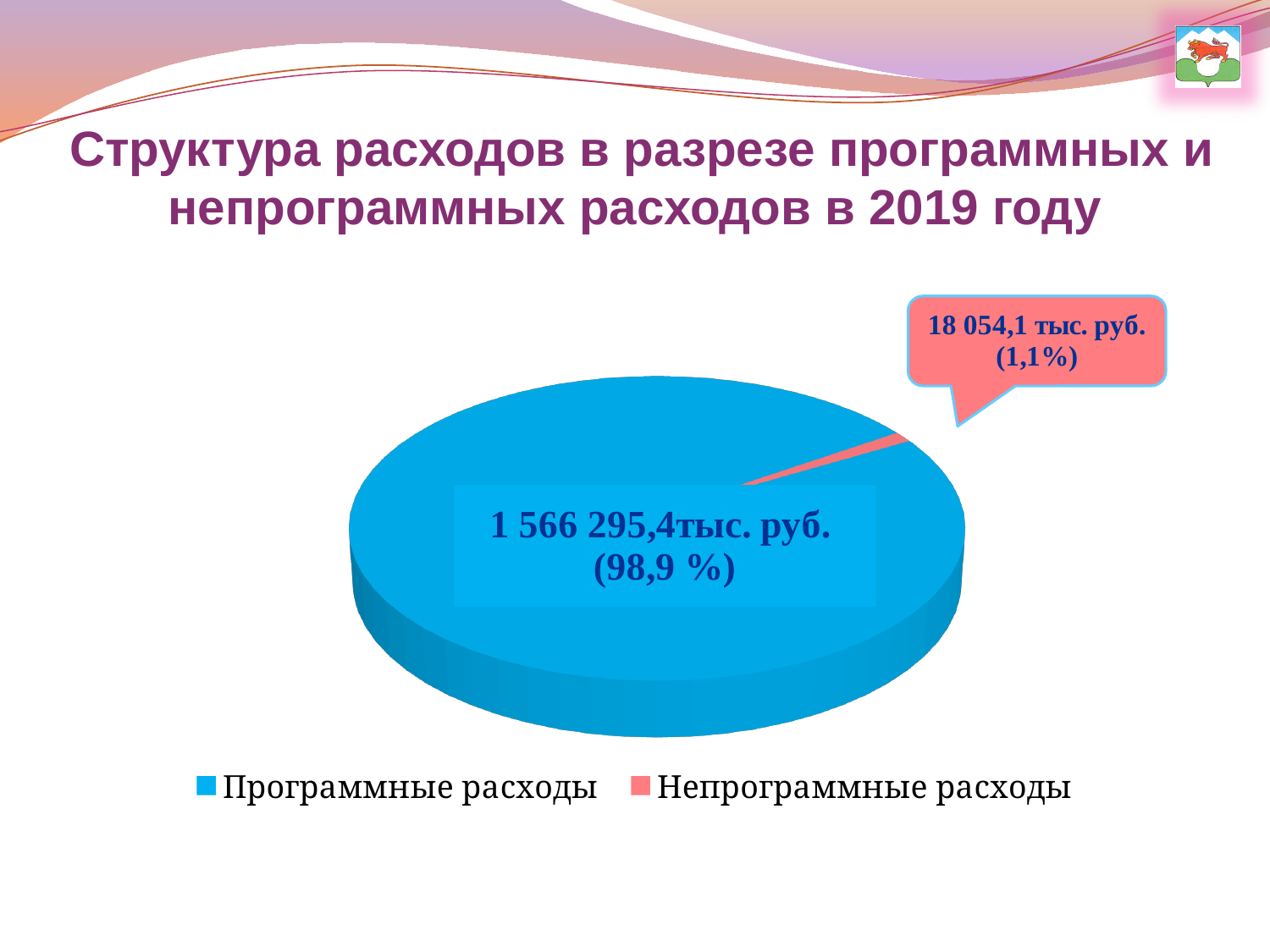
Which category has the largest slice of the pie? Программные расходы Which category has the smallest slice of the pie? Непрограммные расходы What is the difference in percentage share between Программные расходы and Непрограммные расходы? 97,8 % What is the value for Непрограммные расходы? 18 054,1 тыс. руб. What share of the pie does Непрограммные расходы represent? 1,1% What kind of chart is shown on the slide? pie chart What is the title of the slide containing the chart? Структура расходов в разрезе программных и непрограммных расходов в 2019 году What colour is the slice for Непрограммные расходы? pink/red What is the value for Программные расходы? 1 566 295,4 тыс. руб. Which is larger, Программные расходы or Непрограммные расходы? Программные расходы How many categories does the pie chart show? 2 What share of the pie does Программные расходы represent? 98,9 %